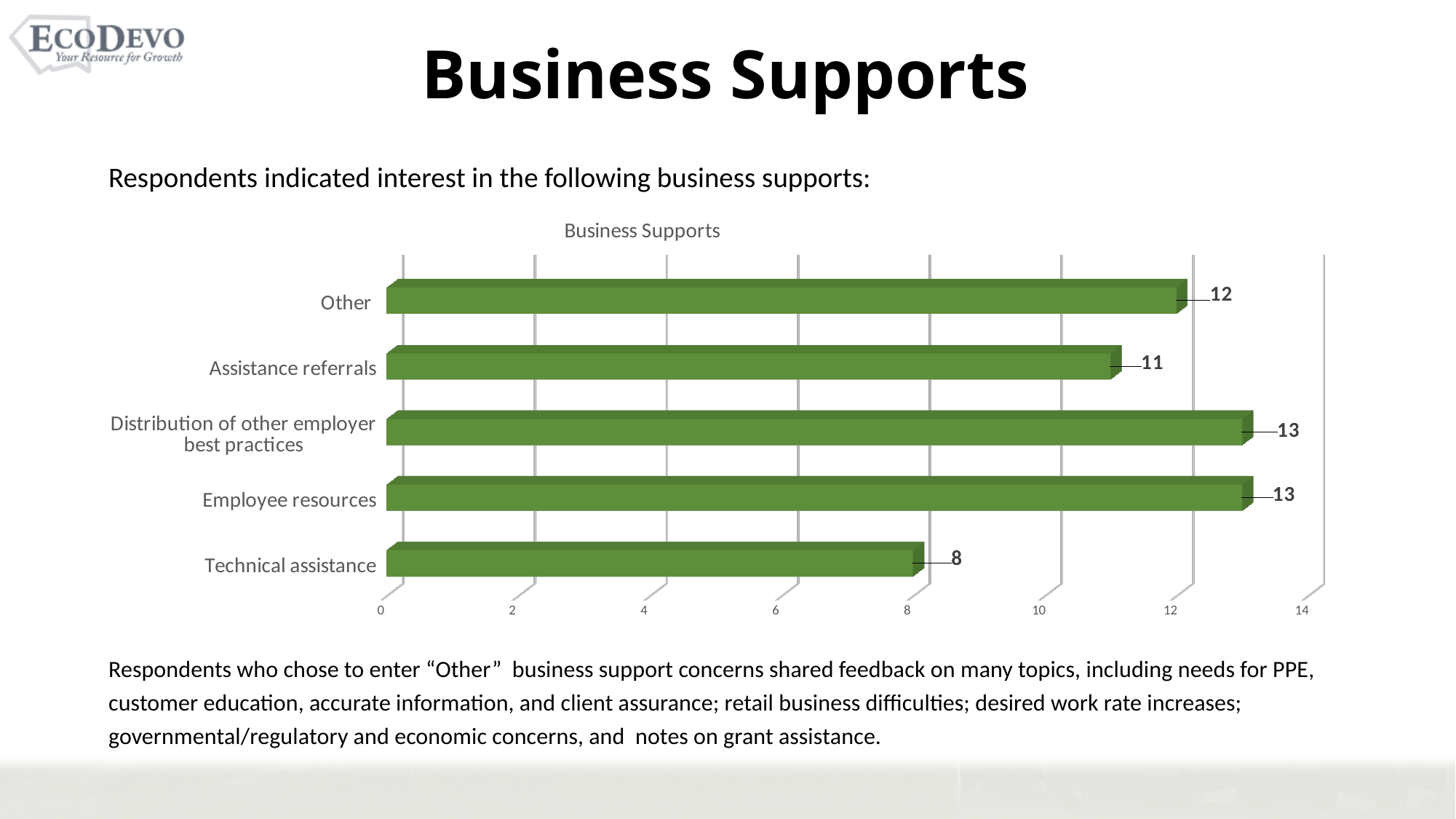
What is the value for Technical assistance? 8 What is the difference between the values for Other and Assistance referrals? 1 Which category has the lowest value? Technical assistance What is the value for Other? 12 Is the value for Technical assistance greater or less than 10? less What is the value for Assistance referrals? 11 Which is larger, the value for Other or the value for Assistance referrals? Other What kind of chart is shown on the slide? bar chart What is the title of the chart? Business Supports What is the value for Employee resources? 13 How many categories are shown in the chart? 5 What is the difference between the values for Employee resources and Technical assistance? 5